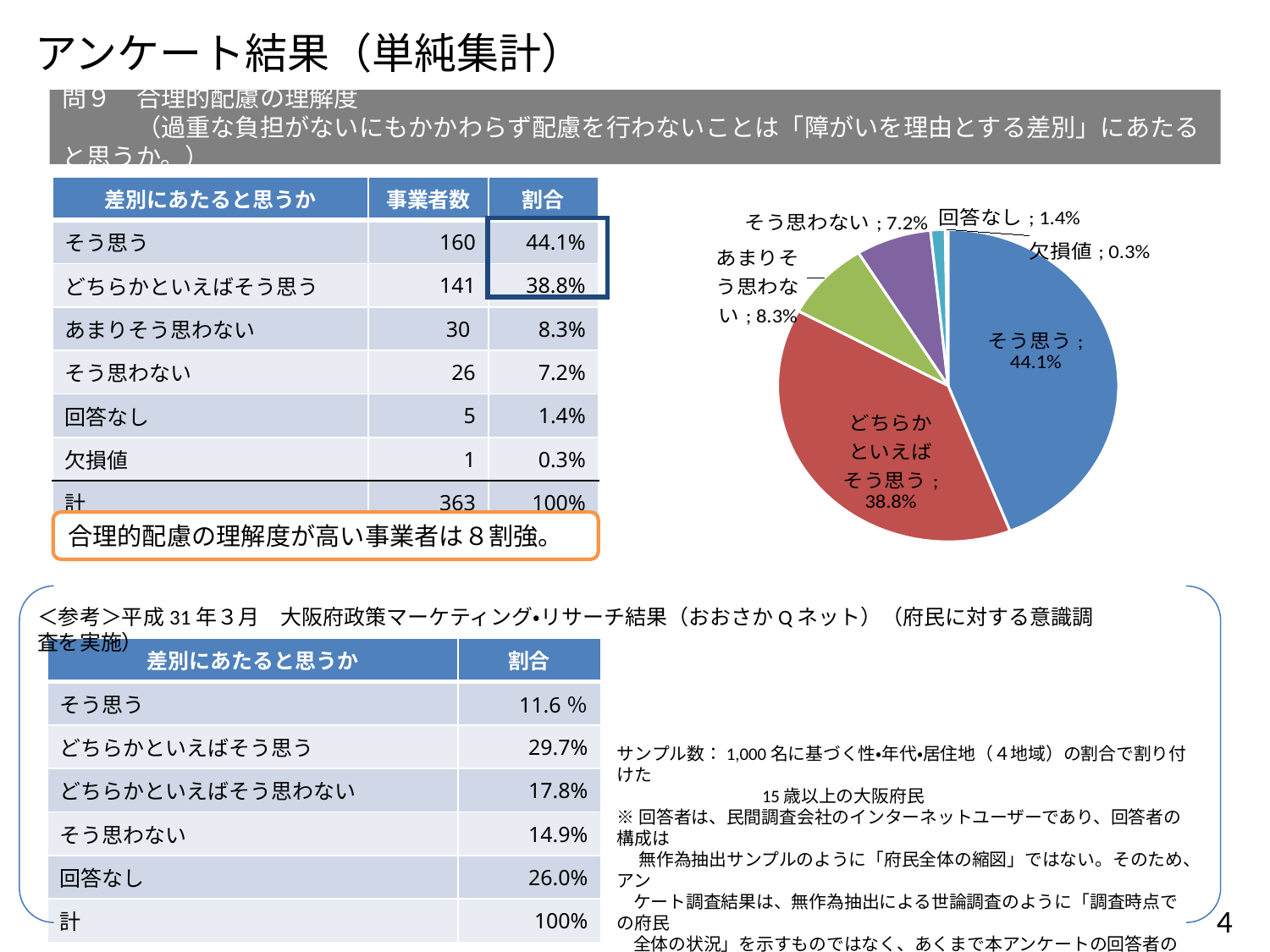
In the pie chart, what is the share for そう思わない? 7.2% In the pie chart, what is the difference between the shares for そう思う and どちらかといえばそう思う? 5.3% In the pie chart, what is the share for あまりそう思わない? 8.3% In the pie chart, what is the share for 欠損値? 0.3% How many slices does the pie chart have? 6 In the pie chart, what is the share for 回答なし? 1.4% Which slice of the pie chart is the smallest? 欠損値 In the pie chart, what is the share for そう思う? 44.1% Which slice of the pie chart is the largest? そう思う What type of chart is shown on the slide? pie chart In the pie chart, which is larger: あまりそう思わない or そう思わない? あまりそう思わない In the pie chart, what is the share for どちらかといえばそう思う? 38.8%